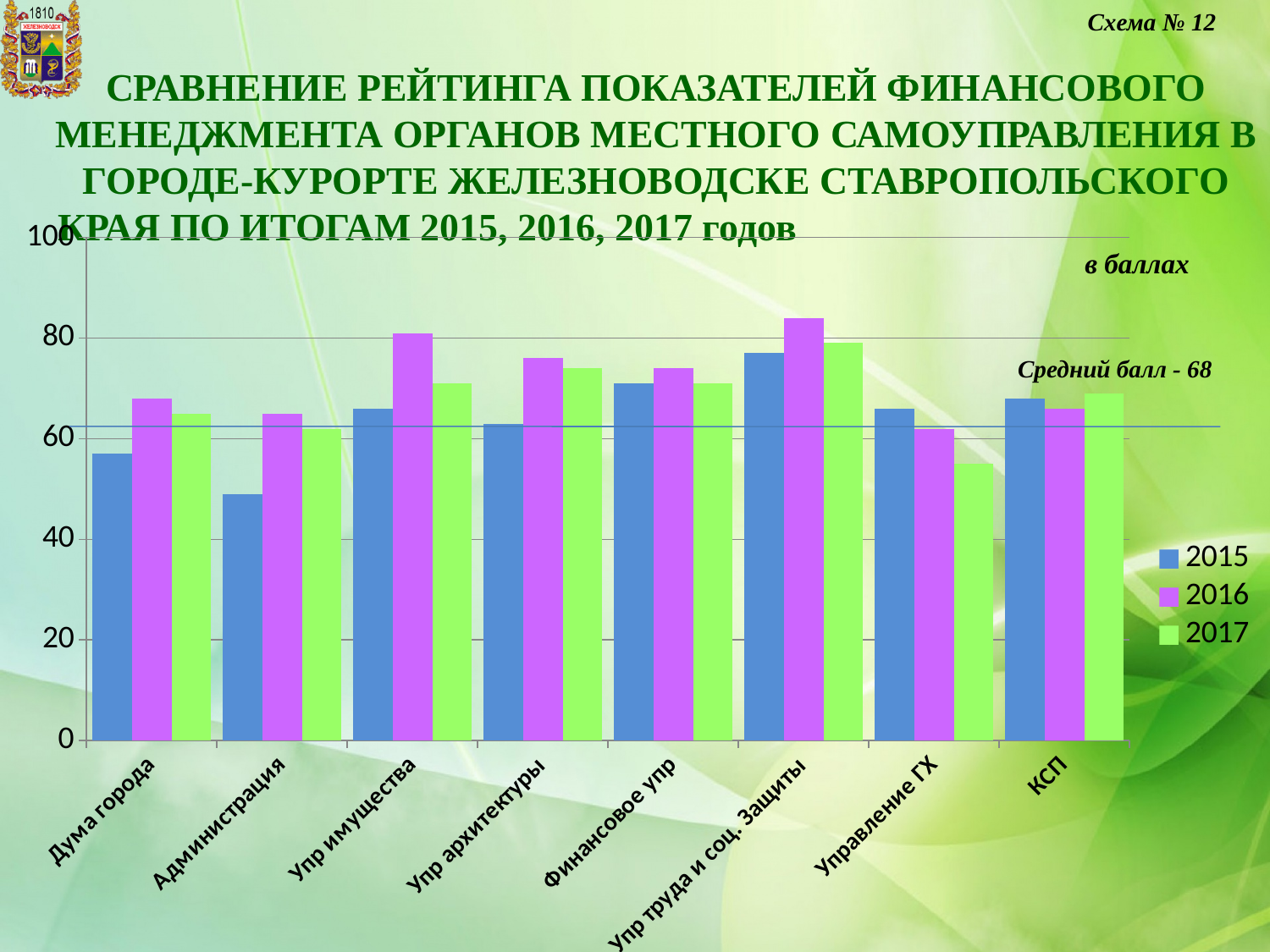
Which category has the highest value for the 2016 series? Упр труда и соц. защиты What are the entries listed in the legend? 2015, 2016, 2017 Is the 2017 value for Управление ГХ greater or less than 60? less Is the 2016 value for Упр труда и соц. защиты greater or less than 80? greater Which category has the lowest value for the 2017 series? Управление ГХ How many series does the legend list? 3 Which category has the lowest value for the 2015 series? Администрация Is the 2015 value for Администрация greater or less than 60? less What average score (Средний балл) is annotated on the chart? 68 Which is larger for 2015: the value for Администрация or the value for Упр имущества? Упр имущества What kind of chart is shown on the slide? bar chart How many categories are shown along the x axis? 8